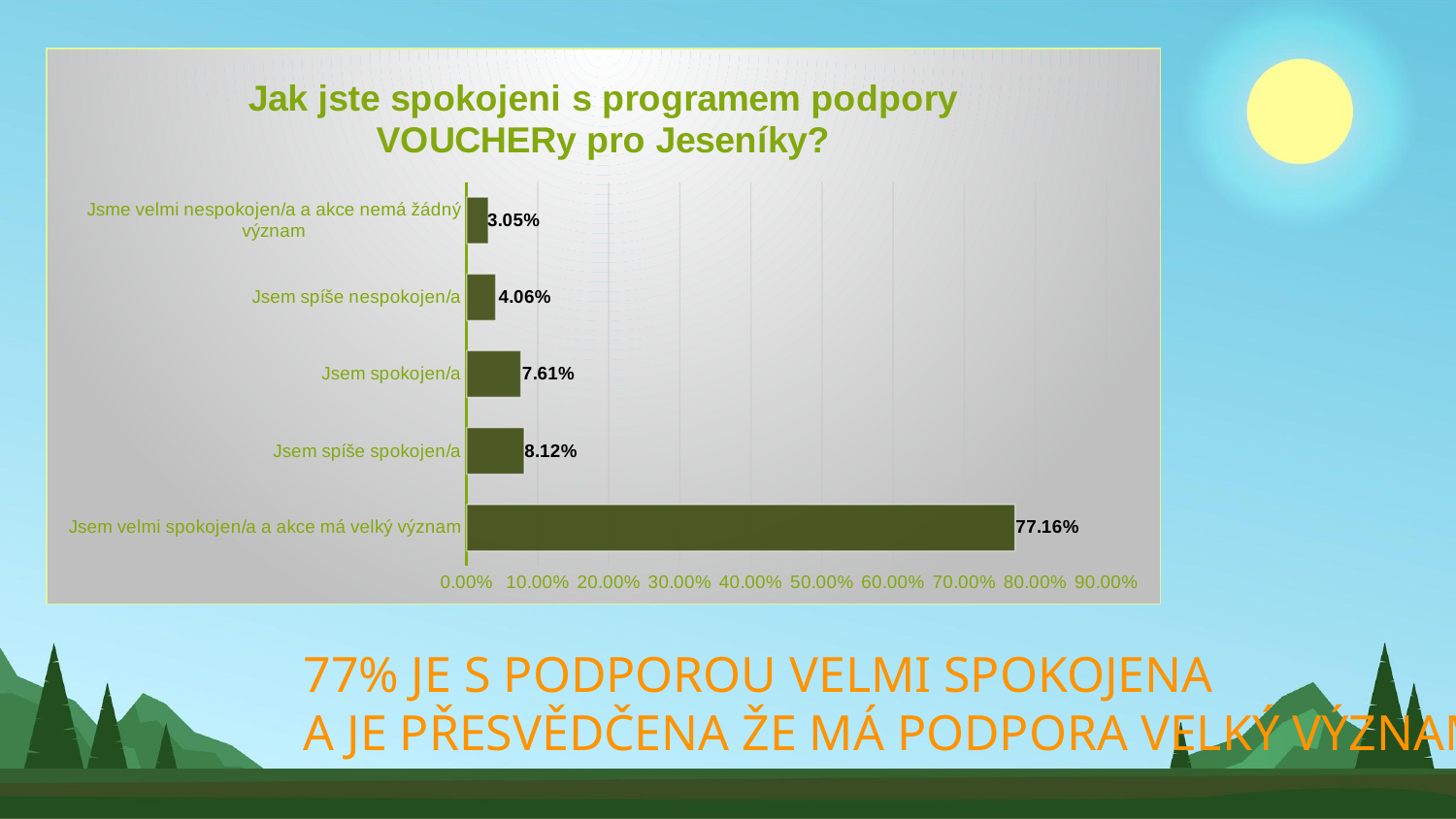
What is the value for "Jsem spíše nespokojen/a"? 4.06% Which category has the highest value? Jsem velmi spokojen/a a akce má velký význam What is the value for "Jsem spokojen/a"? 7.61% What kind of chart is shown on the slide? bar chart Which is larger: the value for "Jsem spíše nespokojen/a" or the value for "Jsme velmi nespokojen/a a akce nemá žádný význam"? Jsem spíše nespokojen/a What is the highest value shown on the x axis? 90.00% What is the difference between the values for "Jsem spíše spokojen/a" and "Jsem spokojen/a"? 0.51% What is the title of the chart? Jak jste spokojeni s programem podpory VOUCHERy pro Jeseníky? What is the value for "Jsem velmi spokojen/a a akce má velký význam"? 77.16% Is the value for "Jsem velmi spokojen/a a akce má velký význam" greater or less than 70.00%? greater Which category has the lowest value? Jsme velmi nespokojen/a a akce nemá žádný význam How many categories are shown in the chart? 5